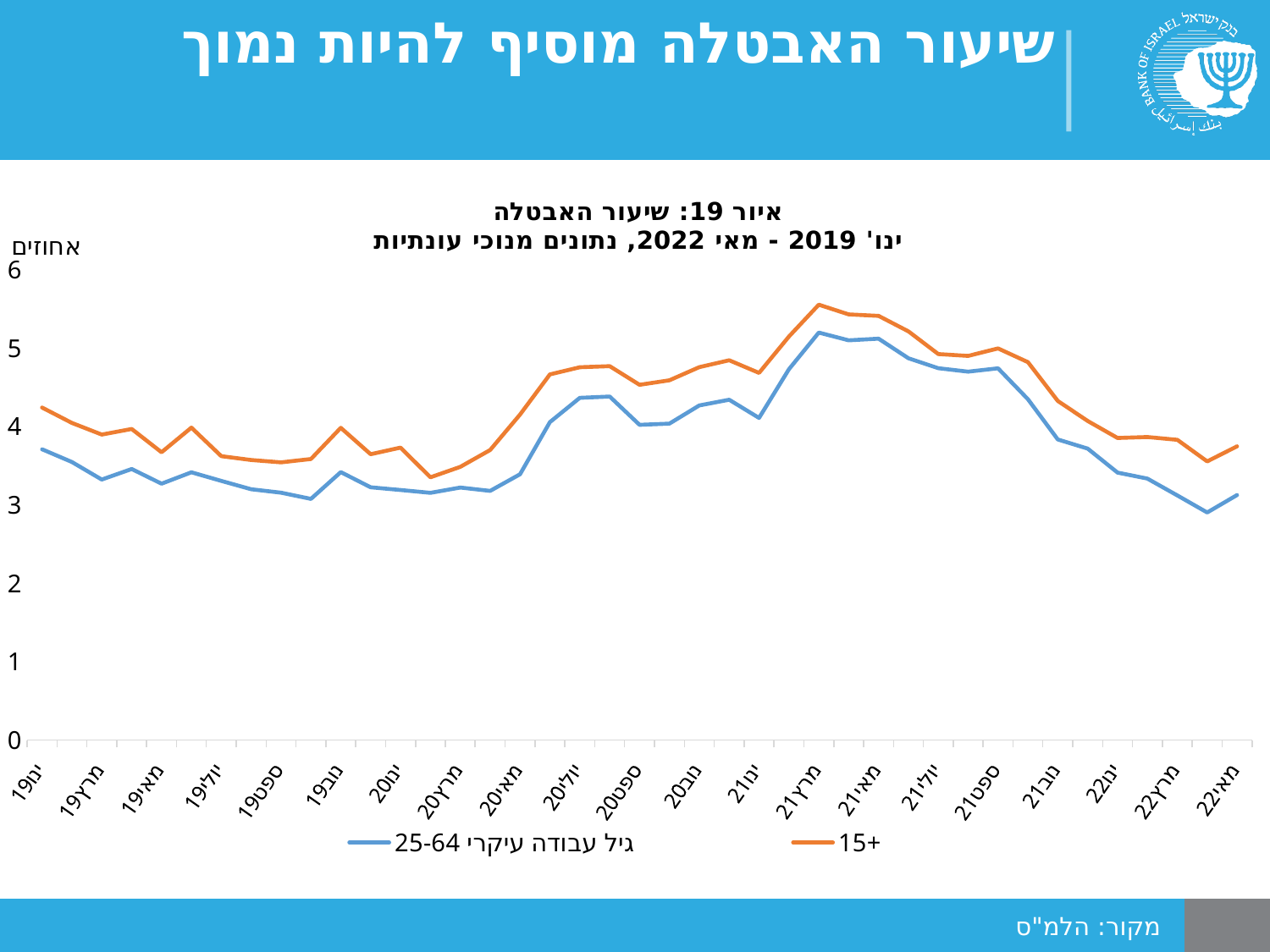
What kind of chart is shown on the slide? line chart What unit is shown on the vertical axis? אחוזים At which month does the 15+ series reach its highest value? מרץ21 Is the value for 25-64 at ינו19 greater or less than 3? greater Which series is drawn in orange? 15+ At which month does the 25-64 series reach its highest value? מרץ21 Is the value for 15+ at מאי22 greater or less than 4? less Which series has the higher value at ינו21, 15+ or 25-64? 15+ Do the values of the 15+ series rise or fall from מרץ21 to מרץ22? fall How many series does the legend list? 2 Is the value for 15+ at מרץ21 greater or less than 5? greater